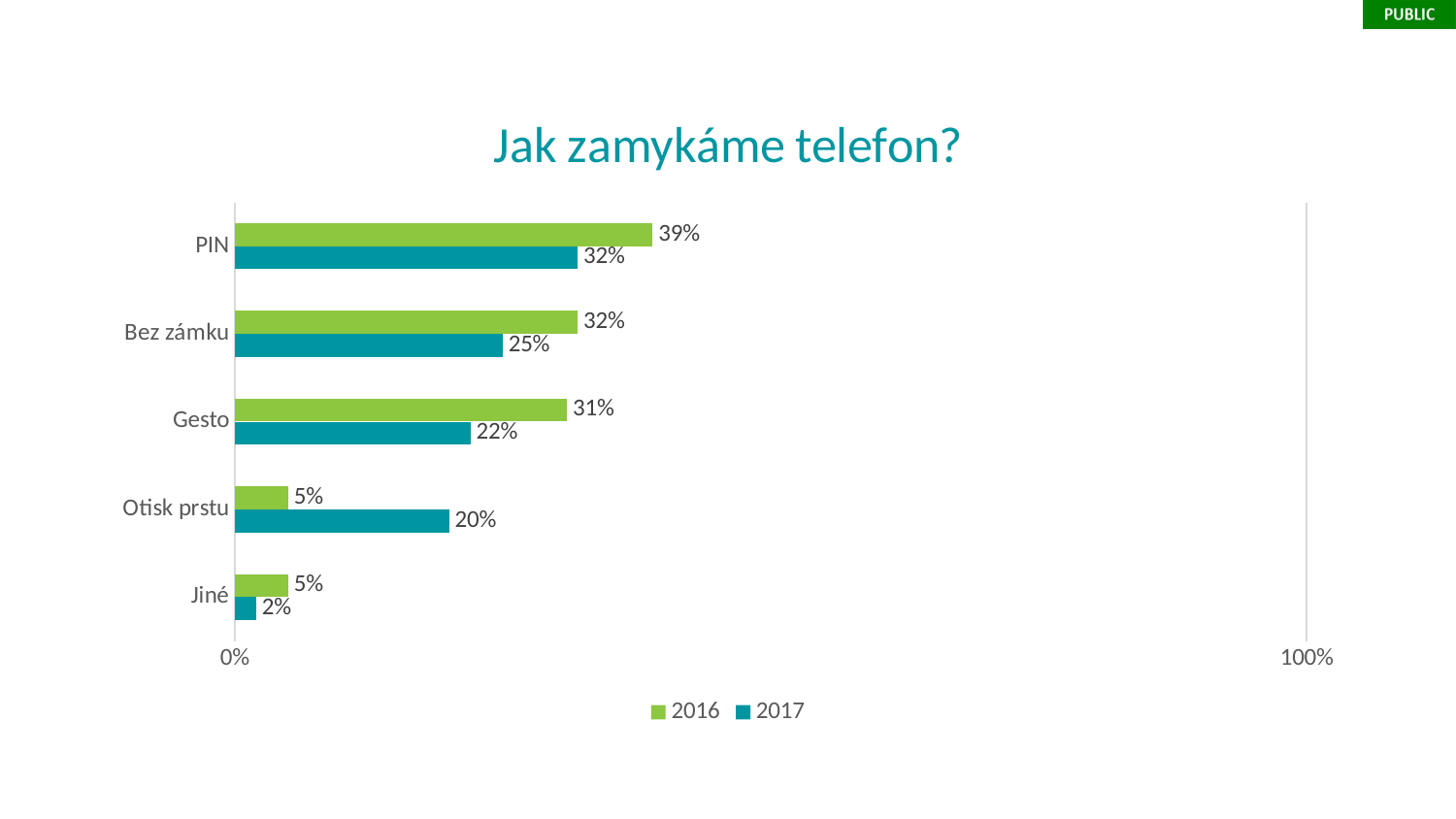
What is the value for Gesto in 2017? 22% What is the value for PIN in 2016? 39% Which is larger for Otisk prstu: the 2016 value or the 2017 value? 2017 What is the value for Otisk prstu in 2017? 20% How many series does the legend list? 2 Which category has the lowest value in 2017? Jiné How many categories are shown on the chart? 5 Which category has the highest value in 2017? PIN What is the difference between the 2016 and 2017 values for Bez zámku? 7% Which series is shown in green in the legend? 2016 What is the title of the chart? Jak zamykáme telefon? What kind of chart is shown on the slide? bar chart